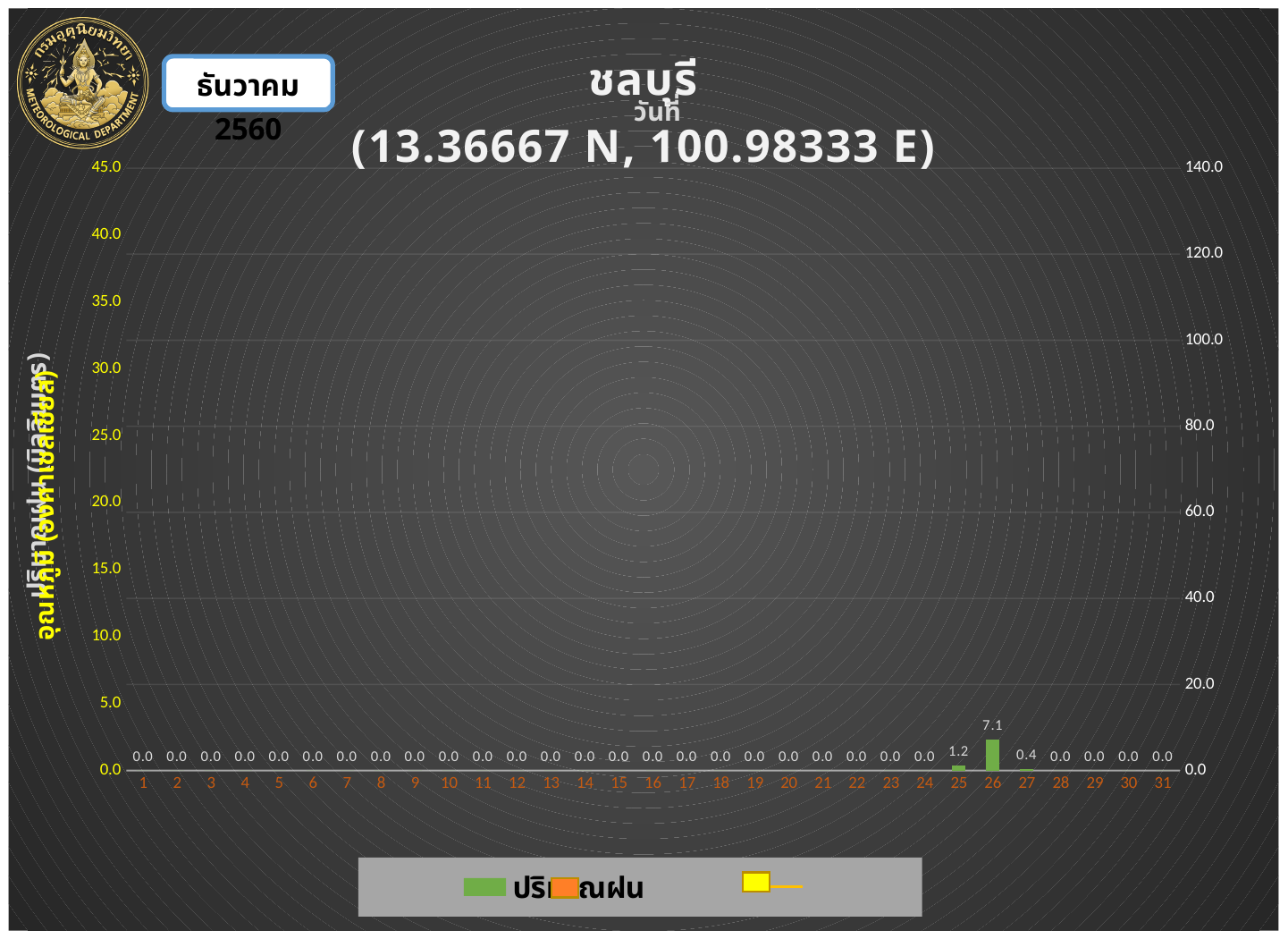
What is the rainfall value shown for day 26? 7.1 What kind of chart is shown on the slide? bar chart What is the rainfall value shown for day 10? 0.0 What is the difference between the rainfall values for day 25 and day 27? 0.8 Is the rainfall value for day 26 greater or less than 10.0 on the left axis? less What is the rainfall value shown for day 27? 0.4 What coordinates are given in the chart title? 13.36667 N, 100.98333 E Which day has the highest rainfall value? 26 Which is larger, the rainfall value for day 26 or for day 27? day 26 What is the difference between the rainfall values for day 26 and day 25? 5.9 How many days are shown on the x axis? 31 What is the rainfall value shown for day 25? 1.2